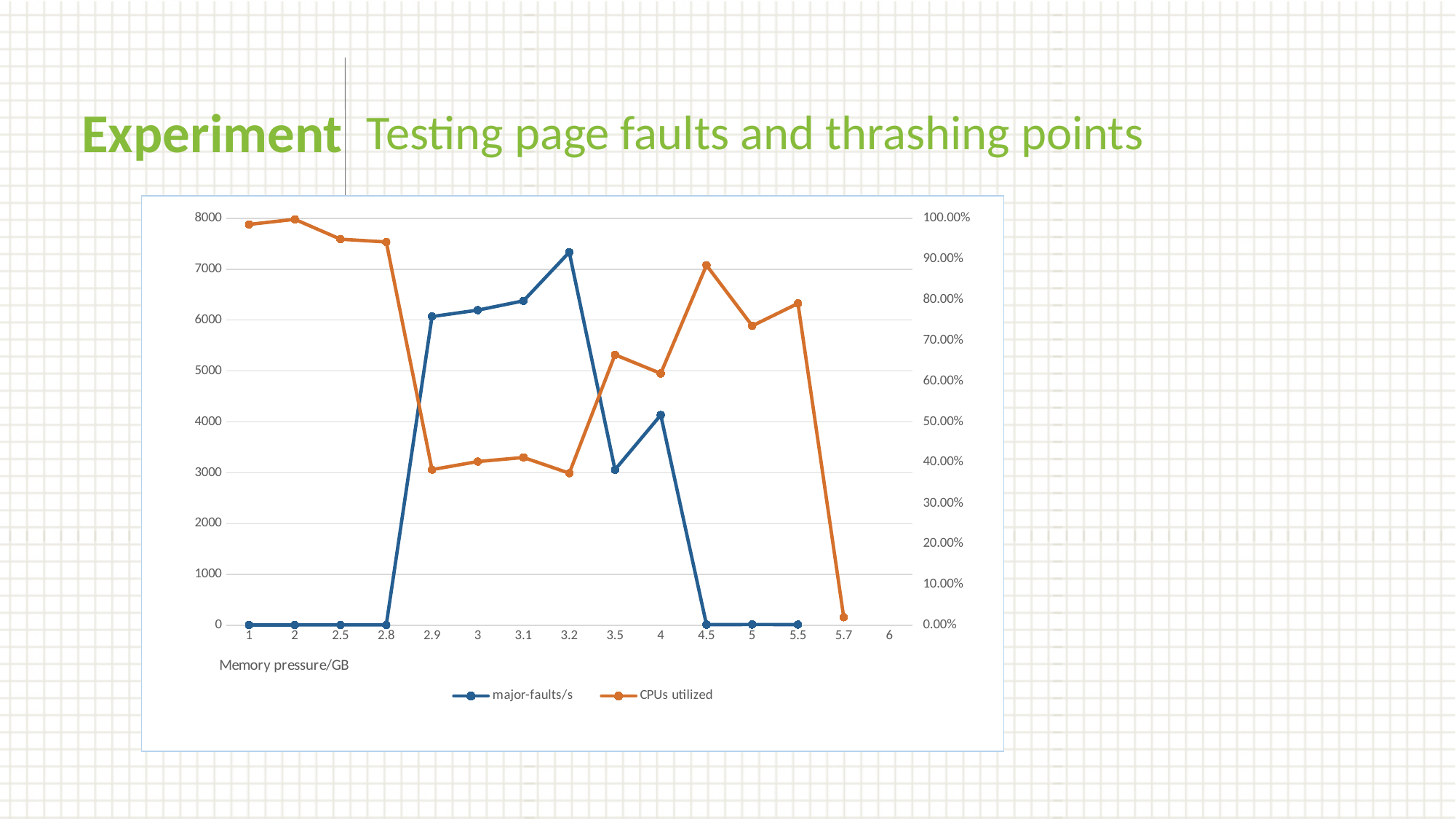
Does major-faults/s rise or fall between memory pressure 3.2 and 4.5? fall What kind of chart is shown on the slide? line chart At which memory pressure value is major-faults/s highest? 3.2 How many series does the legend list? 2 How many memory pressure categories are shown on the x axis? 15 Is the value of major-faults/s at memory pressure 3.2 greater or less than 7000? greater What is the x-axis label of the chart? Memory pressure/GB Is the value of CPUs utilized at memory pressure 2.9 greater or less than 50.00%? less Which is larger: major-faults/s at memory pressure 3.2 or at memory pressure 2.9? 3.2 At which memory pressure value is CPUs utilized lowest? 5.7